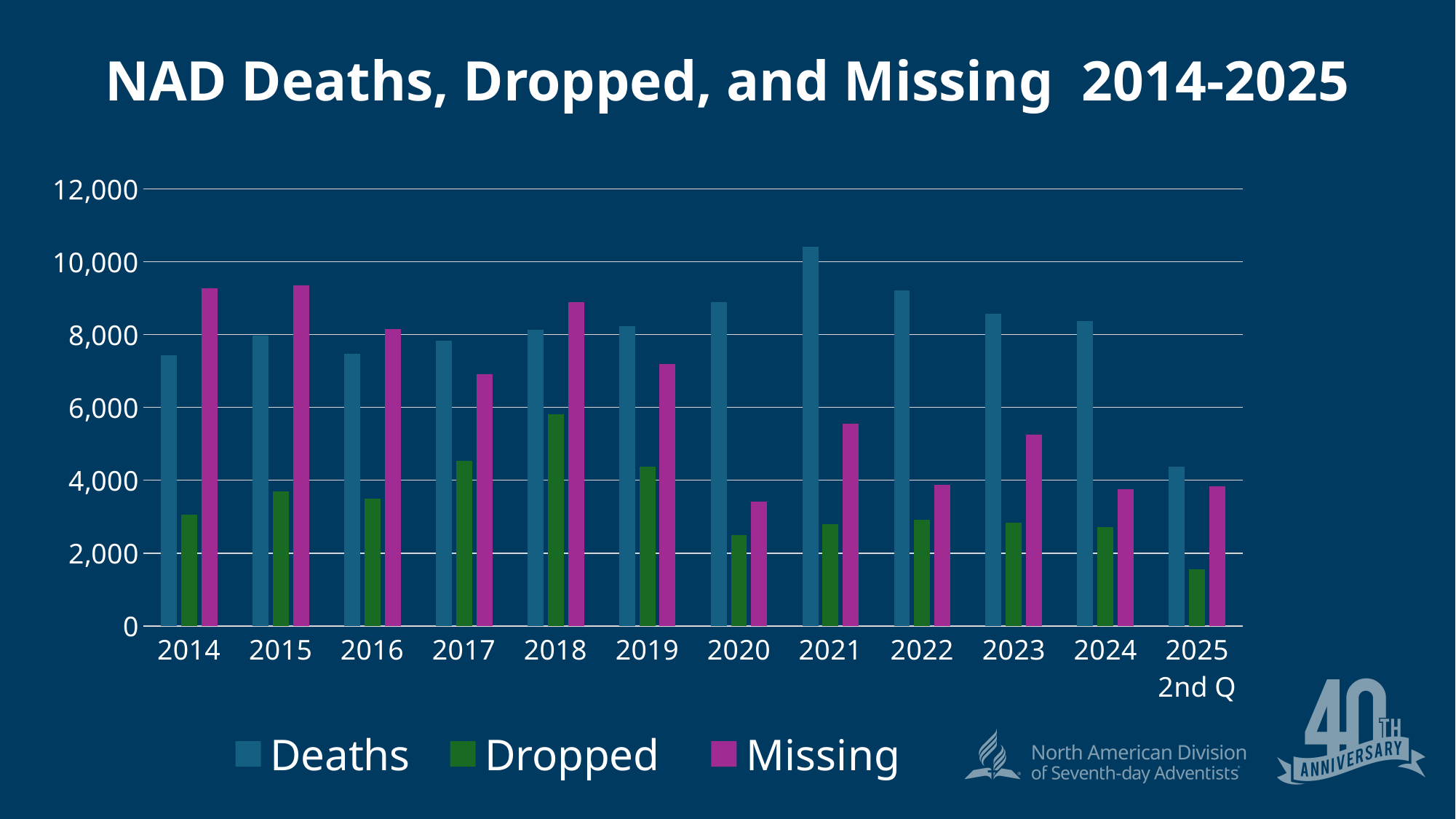
How many series does the legend list? 3 In which year is the Deaths value lowest? 2025 In which year is the Dropped value highest? 2018 Is the Deaths value for 2021 greater or less than 10,000? greater How many years are shown along the x axis? 12 Does the Missing value rise or fall from 2018 to 2020? Fall Which is larger, the Missing value for 2017 or the Missing value for 2018? 2018 Is the Missing value for 2020 greater or less than 4,000? less What type of chart is shown on the slide? Bar chart In which year is the Deaths value highest? 2021 What colour represents the Missing series in the legend? Magenta In which year is the Dropped value lowest? 2025